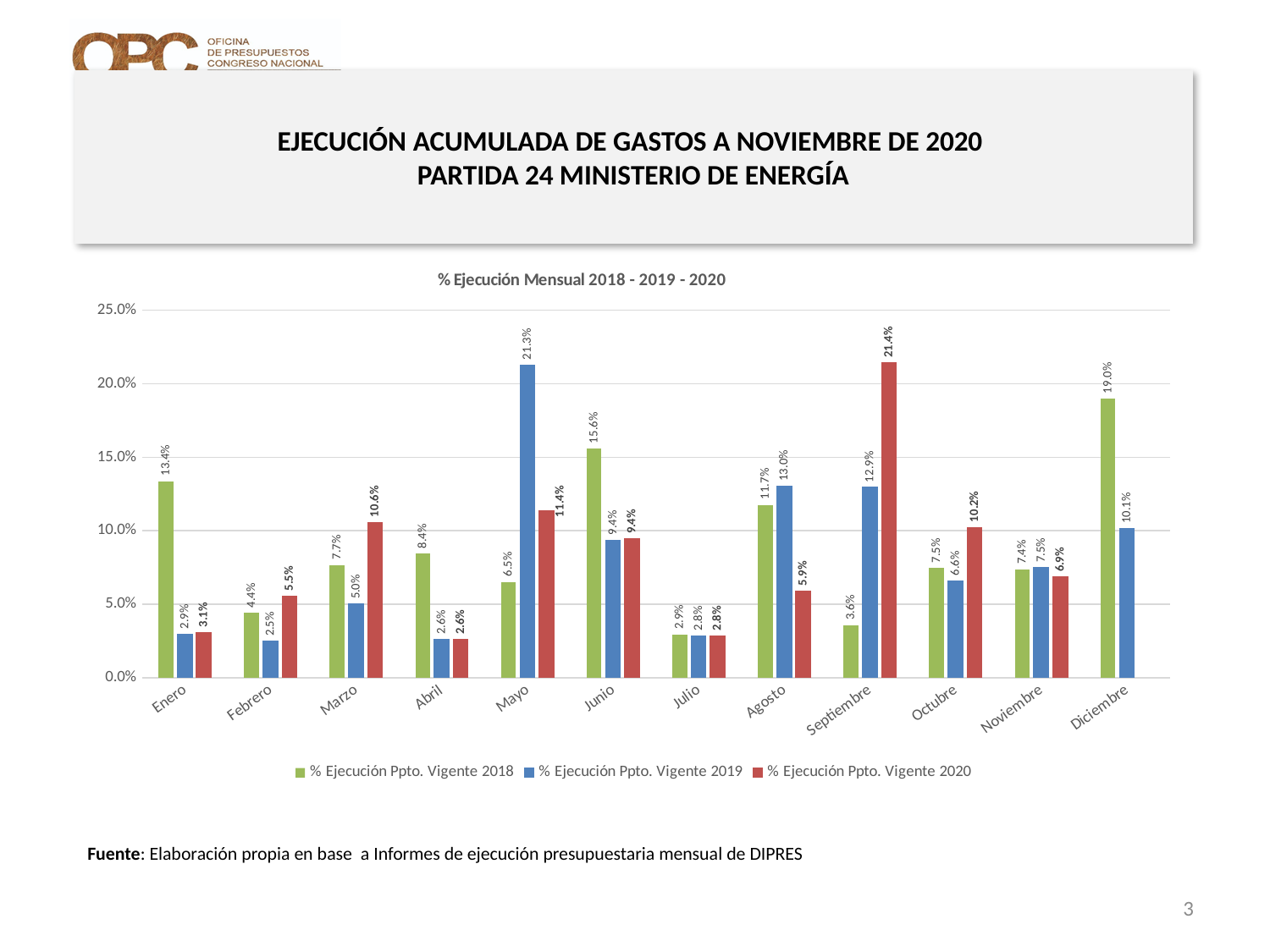
How many months are shown on the x axis? 12 What is the difference between the 2019 and 2018 values for Mayo? 14.8% What is the value for Septiembre in the % Ejecución Ppto. Vigente 2020 series? 21.4% What is the title of the chart? % Ejecución Mensual 2018 - 2019 - 2020 How many series does the legend list? 3 What is the value for Diciembre in the % Ejecución Ppto. Vigente 2018 series? 19.0% Which is larger for Agosto: the 2019 value or the 2020 value? 2019 value (13.0%) What kind of chart is shown on the slide? Bar chart What is the value for Mayo in the % Ejecución Ppto. Vigente 2019 series? 21.3% Which month has the lowest value in the % Ejecución Ppto. Vigente 2018 series? Julio Is the value for Junio in the 2018 series greater or less than 15.0%? greater Which month has the highest value in the % Ejecución Ppto. Vigente 2020 series? Septiembre